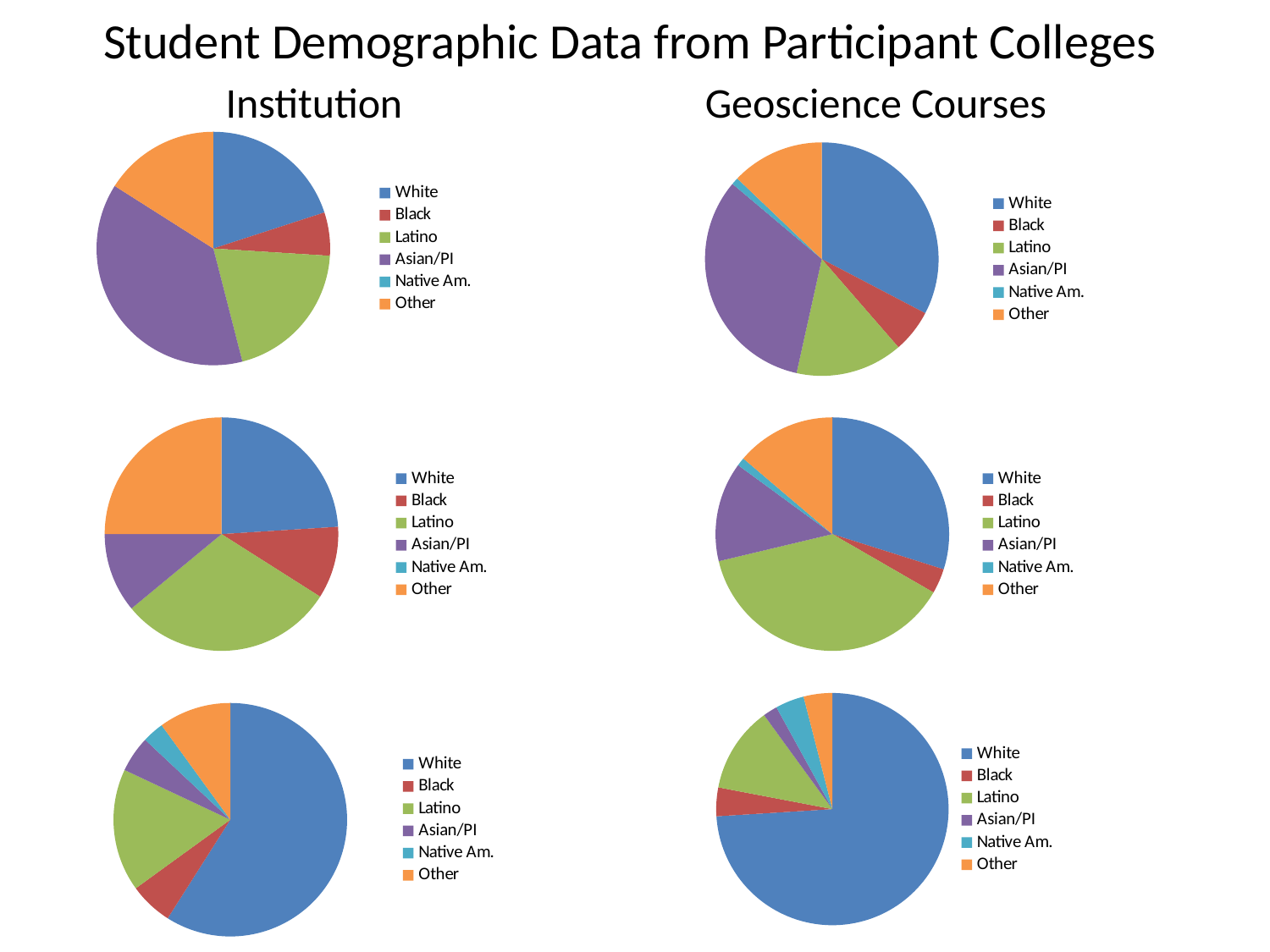
In the middle-right pie chart under Geoscience Courses, which category has the largest slice? Latino How many pie charts are shown on the slide? 6 What is the title of the slide? Student Demographic Data from Participant Colleges In the top-left pie chart under Institution, which slice is larger, Asian/PI or Black? Asian/PI What are the two column headings above the pie charts? Institution and Geoscience Courses What kind of chart is the bottom-left chart under the Institution heading? pie chart In the middle-right pie chart under Geoscience Courses, which slice is larger, Latino or Black? Latino In the top-right pie chart under Geoscience Courses, which category has the smallest slice? Native Am. In the bottom-left pie chart under Institution, which slice is larger, White or Latino? White In the bottom-right pie chart under Geoscience Courses, which category has the largest slice? White How many entries does the legend of the top-left Institution pie chart list? 6 In the top-left pie chart under Institution, which category has the largest slice? Asian/PI